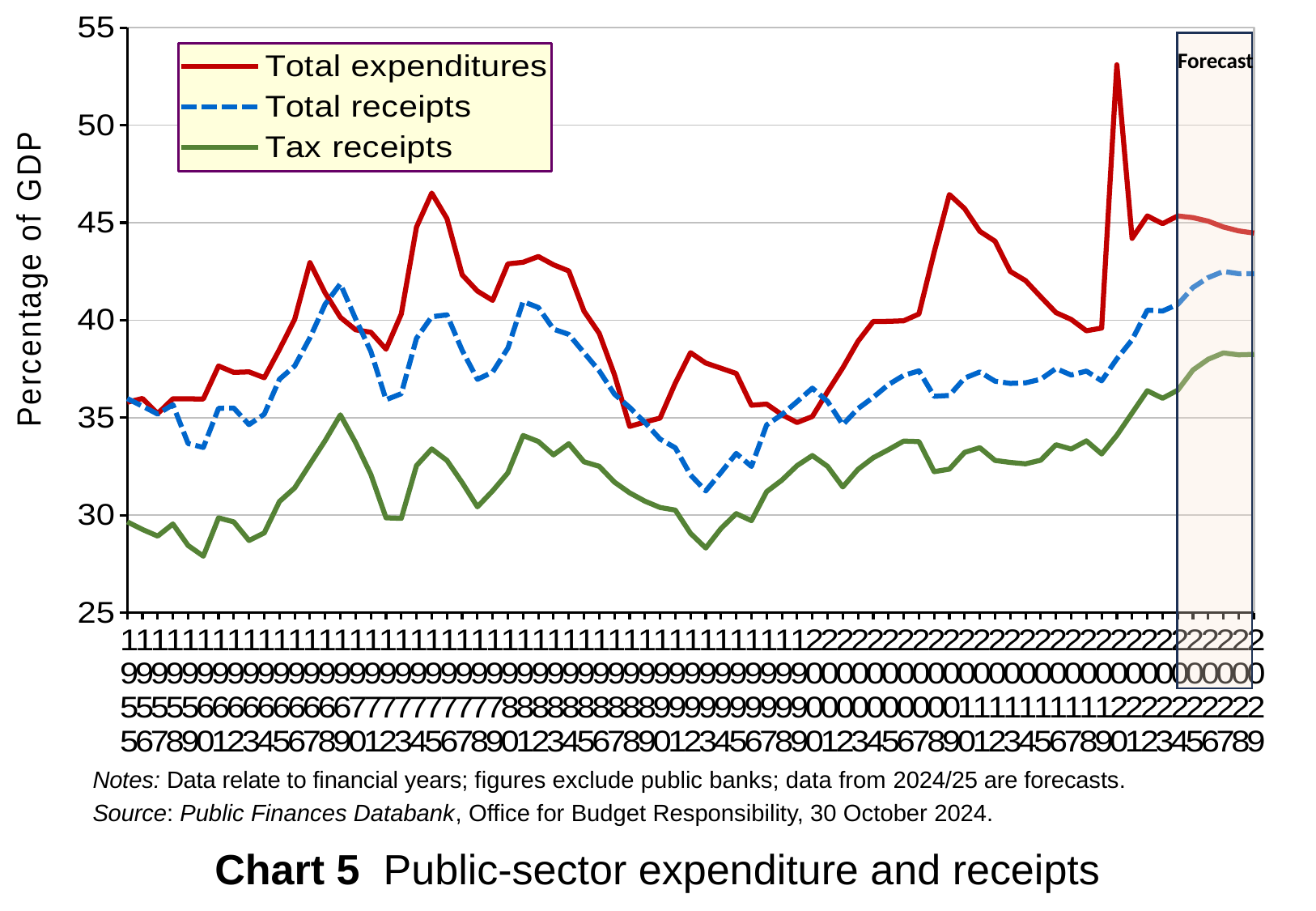
What is the label on the vertical axis? Percentage of GDP Which series reaches the highest value anywhere on the chart? Total expenditures Is the value of Tax receipts at the end of the forecast period (2029) greater or less than 35? greater How many series does the legend list? 3 Which series has the lowest values across the chart? Tax receipts What kind of chart is shown on the slide? line chart Is the peak value of Total expenditures around 2020 greater or less than 50? greater Does Total expenditures rise or fall between 2020 and 2021? fall What is the title of the chart? Chart 5 Public-sector expenditure and receipts At the 2020 peak, which is larger: Total expenditures or Total receipts? Total expenditures